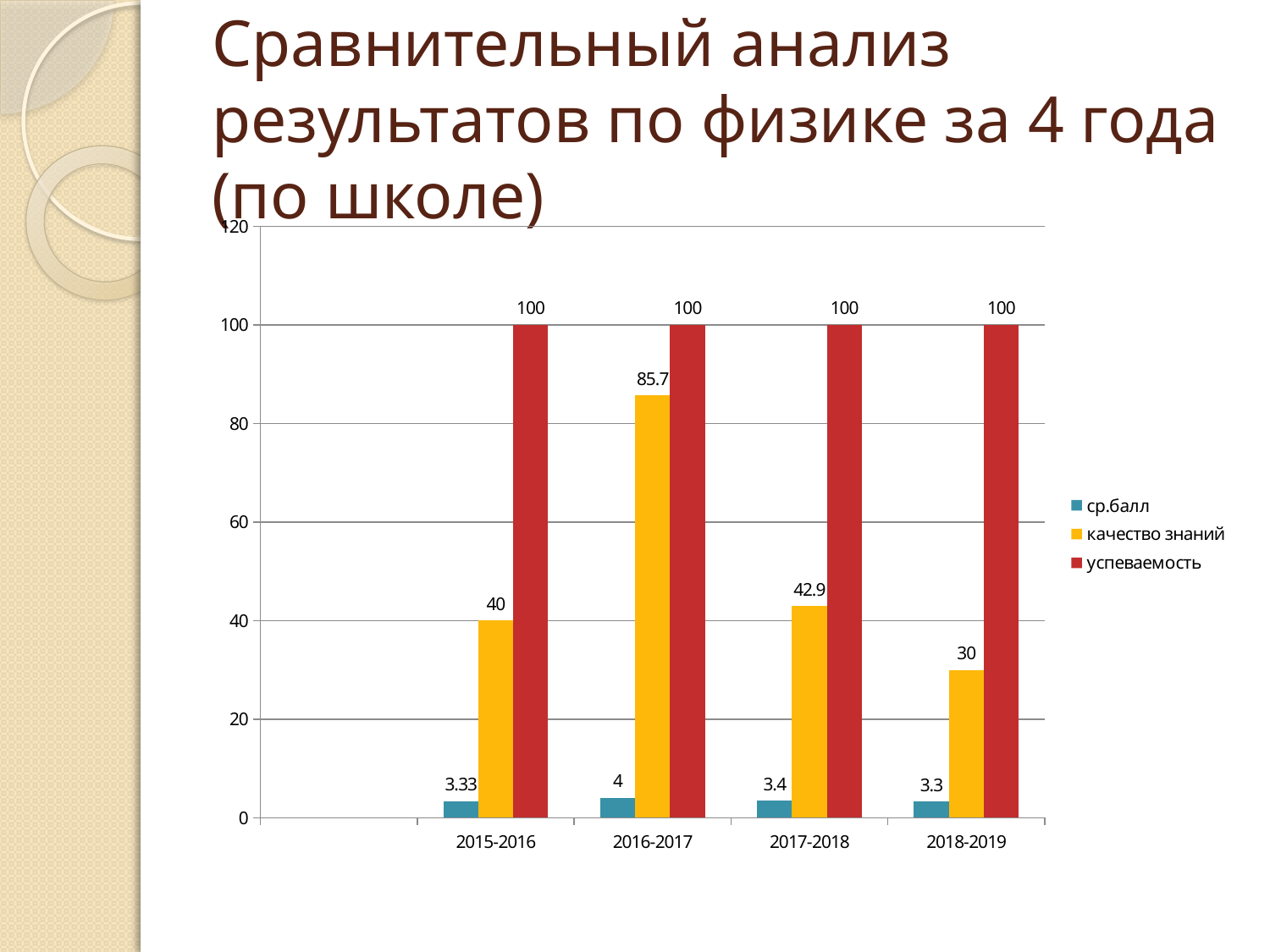
Which series is shown in red? успеваемость Which year has the highest value for качество знаний? 2016-2017 Which is larger: качество знаний in 2015-2016 or in 2017-2018? 2017-2018 What is the value of ср.балл for 2015-2016? 3.33 What is the difference between качество знаний in 2016-2017 and 2017-2018? 42.8 What is the value of качество знаний for 2016-2017? 85.7 Which year has the lowest value for качество знаний? 2018-2019 How many series does the legend list? 3 What kind of chart is shown on the slide? bar chart How many years (categories) are shown on the x axis? 4 What is the value of успеваемость for 2018-2019? 100 Is the value of качество знаний for 2016-2017 greater or less than 80? greater